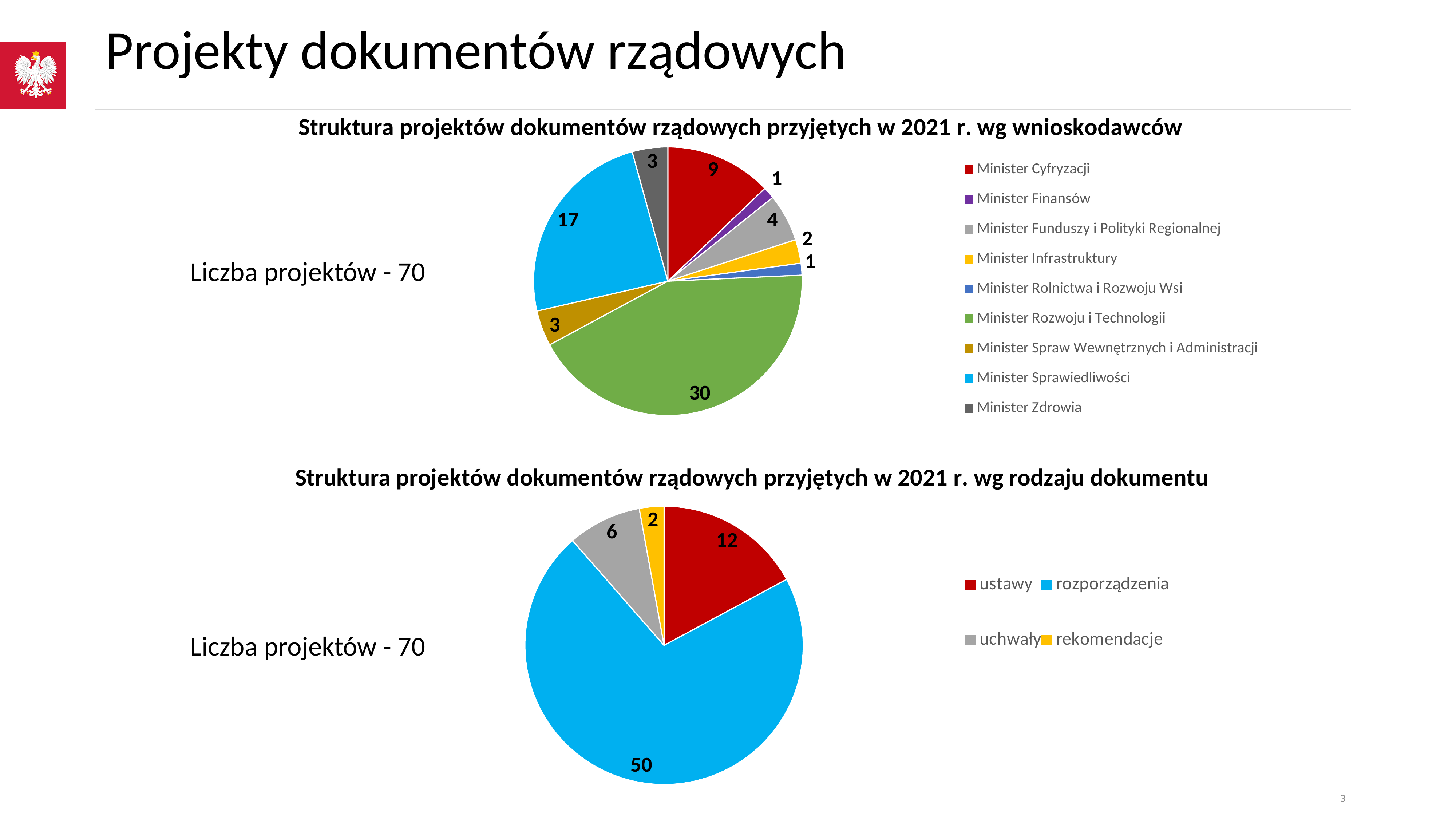
In the top chart (wg wnioskodawców), how many applicants does the legend list? 9 In the top chart (wg wnioskodawców), which applicant has the largest slice? Minister Rozwoju i Technologii In the bottom chart (wg rodzaju dokumentu), how many projects are rozporządzenia? 50 In the bottom chart (wg rodzaju dokumentu), how many document types does the legend list? 4 In the bottom chart (wg rodzaju dokumentu), what is the difference between the values for ustawy and uchwały? 6 In the top chart (wg wnioskodawców), which is larger: the value for Minister Funduszy i Polityki Regionalnej or for Minister Infrastruktury? Minister Funduszy i Polityki Regionalnej In the bottom chart (wg rodzaju dokumentu), which document type has the smallest slice? rekomendacje In the top chart (wg wnioskodawców), what is the difference between the values for Minister Rozwoju i Technologii and Minister Sprawiedliwości? 13 What type of chart is the top chart (wg wnioskodawców)? Pie chart In the bottom chart (wg rodzaju dokumentu), what colour is the slice for rozporządzenia? Light blue In the top chart (wg wnioskodawców), how many projects are attributed to Minister Sprawiedliwości? 17 In the top chart (wg wnioskodawców), how many projects are attributed to Minister Cyfryzacji? 9